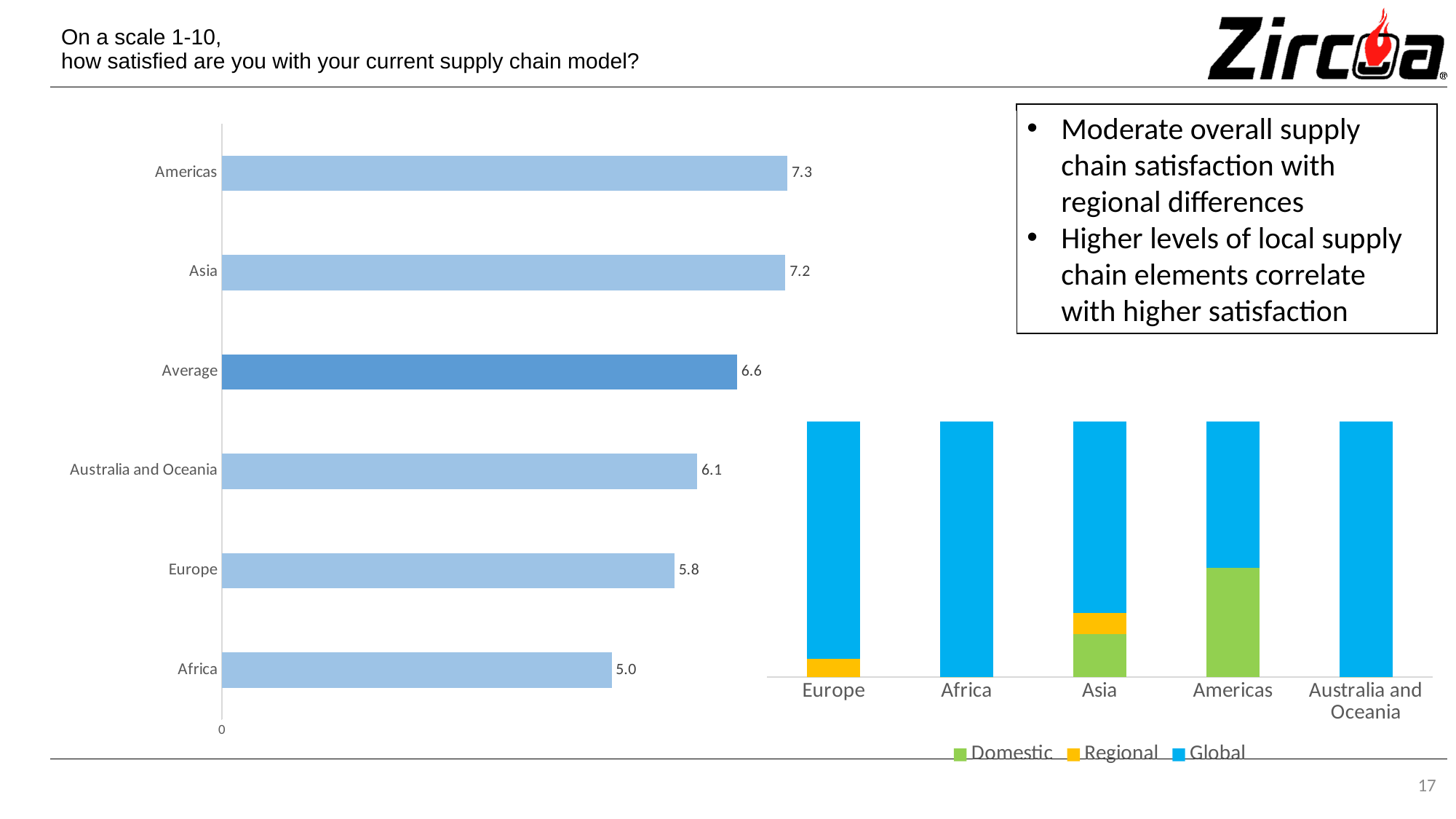
In the left bar chart, what is the satisfaction score for Europe? 5.8 In the left bar chart, what is the difference between the scores for Americas and Africa? 2.3 What type of chart is the chart on the left of the slide? Bar chart In the left bar chart, what is the satisfaction score for Americas? 7.3 How many series does the legend of the right-hand stacked bar chart list? 3 In the right-hand stacked bar chart, which colour represents Global? Blue How many bars are shown in the left bar chart? 6 In the right-hand stacked bar chart, which region has the largest Domestic segment? Americas In the left bar chart, which region has the lowest satisfaction score? Africa In the left bar chart, which has a higher score, Australia and Oceania or Europe? Australia and Oceania In the left bar chart, which region has the highest satisfaction score? Americas In the left bar chart, what is the Average satisfaction score? 6.6